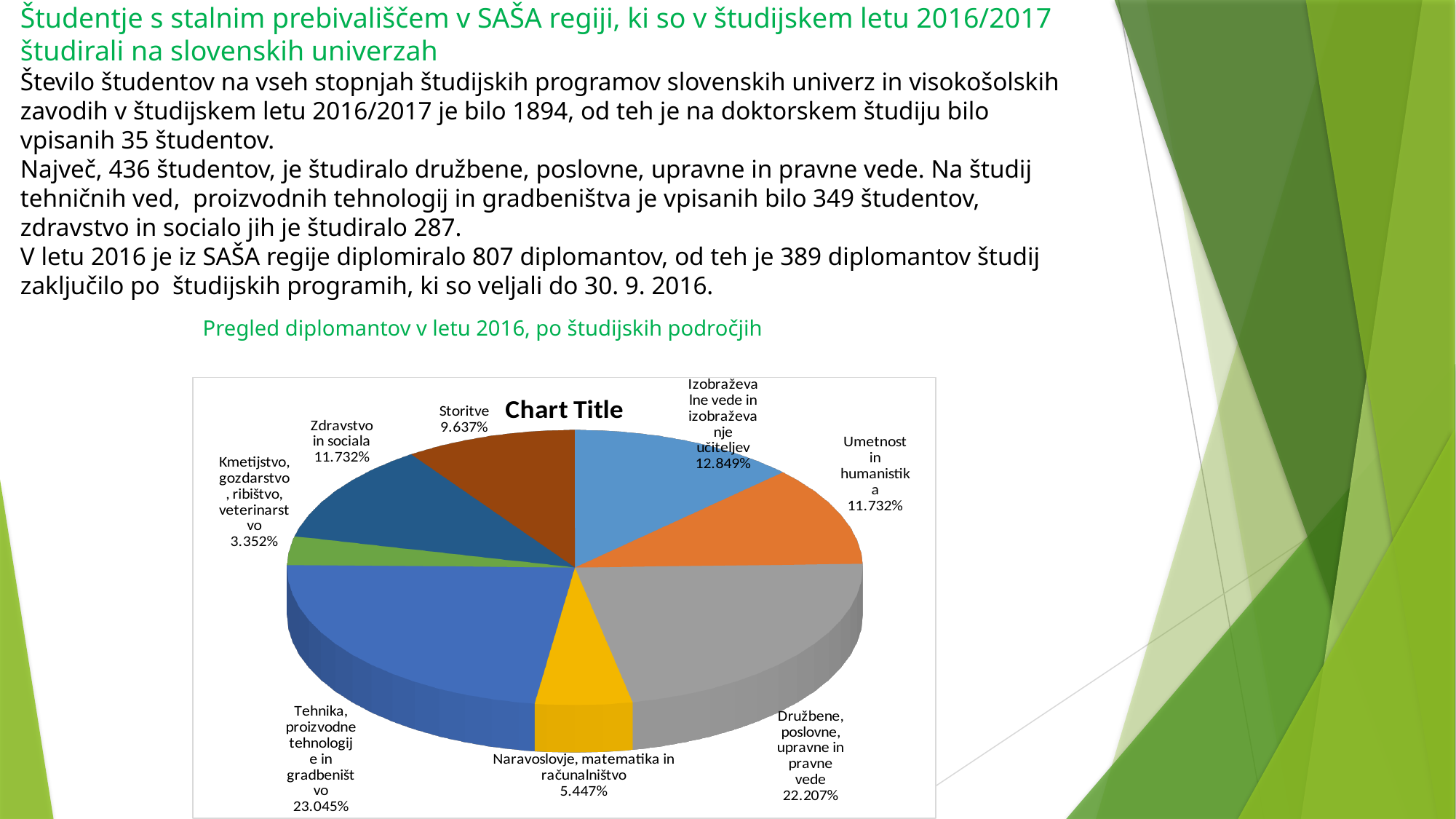
What share of the pie does "Storitve" have? 9.637% What is the difference in percentage points between "Tehnika, proizvodne tehnologije in gradbeništvo" and "Družbene, poslovne, upravne in pravne vede"? 0.838 Which category has the smallest share of the pie? Kmetijstvo, gozdarstvo, ribištvo, veterinarstvo Which has a larger share: "Izobraževalne vede in izobraževanje učiteljev" or "Umetnost in humanistika"? Izobraževalne vede in izobraževanje učiteljev What is the title printed inside the chart area? Chart Title What kind of chart is shown on the slide? pie chart What share of the pie does "Izobraževalne vede in izobraževanje učiteljev" have? 12.849% Which category has the largest share of the pie? Tehnika, proizvodne tehnologije in gradbeništvo What share of the pie does "Zdravstvo in sociala" have? 11.732% How many slices does the pie chart have? 8